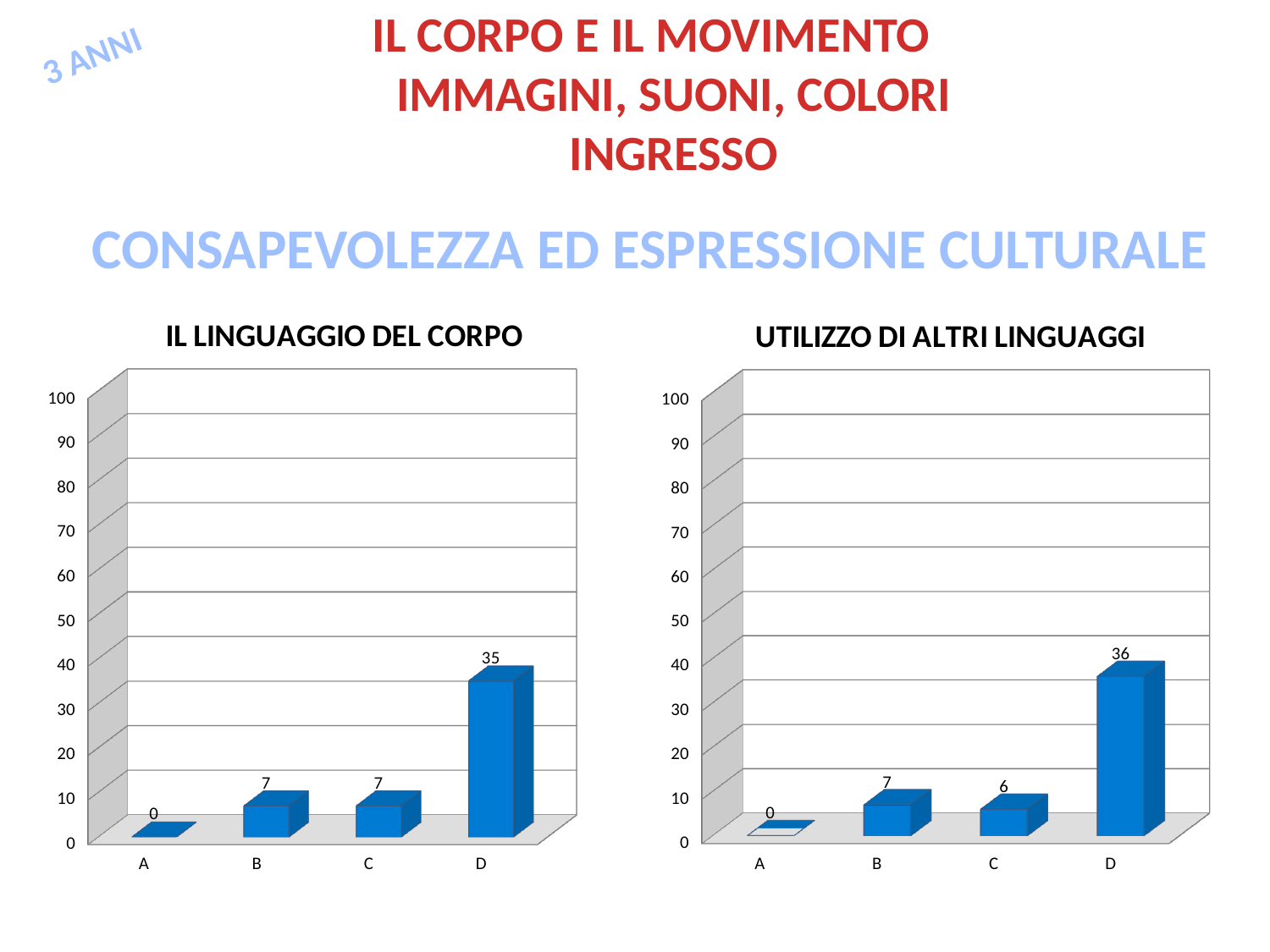
What is the title of the chart on the left side of the slide? IL LINGUAGGIO DEL CORPO In the chart titled 'IL LINGUAGGIO DEL CORPO', is the value for D greater or less than 30? greater In the chart titled 'IL LINGUAGGIO DEL CORPO', what is the difference between the values for D and B? 28 In the chart titled 'UTILIZZO DI ALTRI LINGUAGGI', what is the difference between the values for B and C? 1 What kind of chart is the chart titled 'UTILIZZO DI ALTRI LINGUAGGI'? bar chart In the chart titled 'IL LINGUAGGIO DEL CORPO', what is the value for category D? 35 In the chart titled 'IL LINGUAGGIO DEL CORPO', which category has the highest value? D How many categories are shown in the chart titled 'IL LINGUAGGIO DEL CORPO'? 4 In the chart titled 'UTILIZZO DI ALTRI LINGUAGGI', what is the value for category D? 36 In the chart titled 'UTILIZZO DI ALTRI LINGUAGGI', what is the value for category C? 6 In the chart titled 'UTILIZZO DI ALTRI LINGUAGGI', which is larger, the value for B or the value for C? B In the chart titled 'UTILIZZO DI ALTRI LINGUAGGI', which category has the lowest value? A